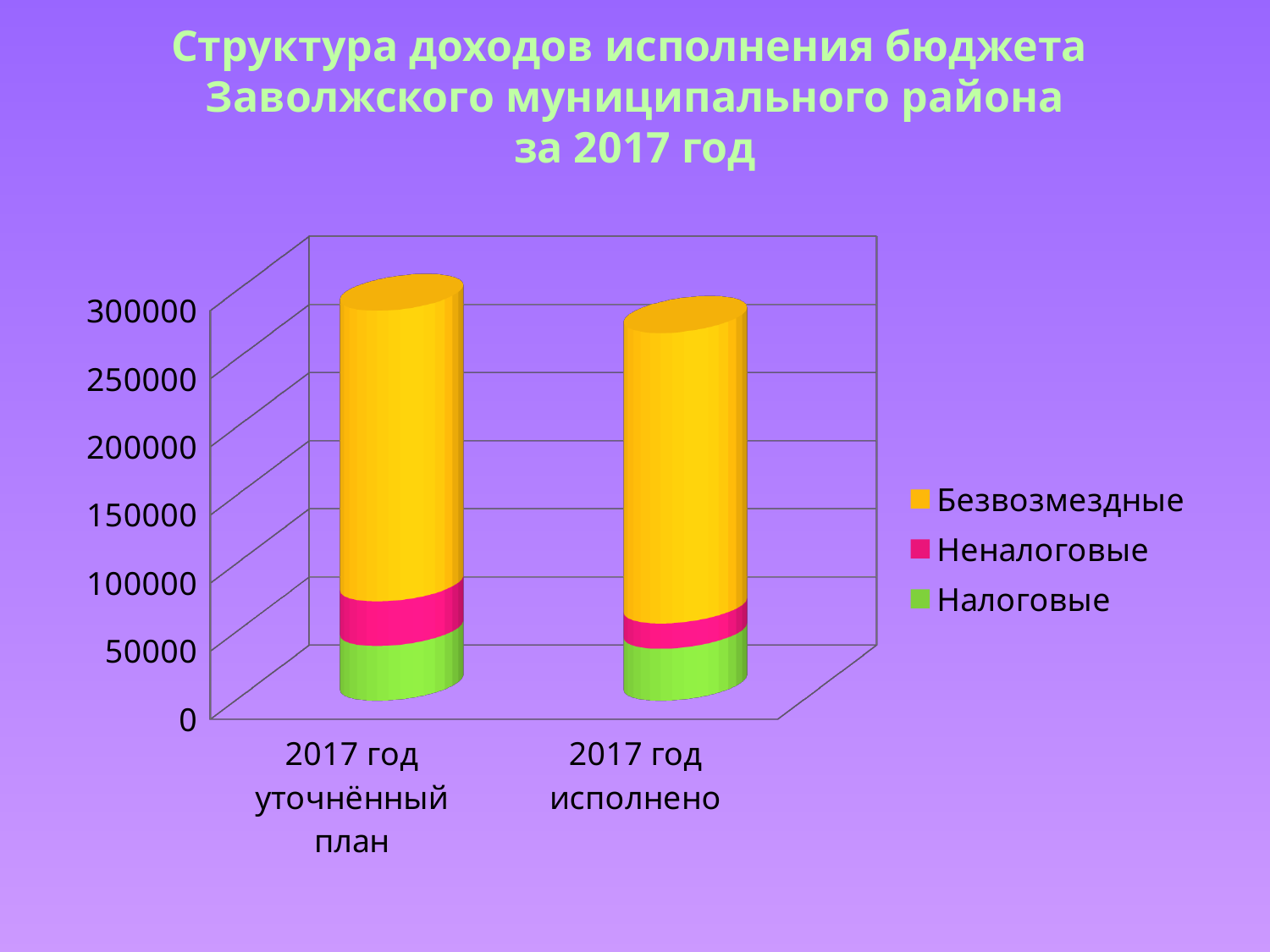
Which series is shown in yellow in the chart? Безвозмездные Is the value of 'Неналоговые' larger for '2017 год уточнённый план' or for '2017 год исполнено'? 2017 год уточнённый план How many series does the legend list? 3 Which series makes up the smallest part of the bar for '2017 год исполнено'? Неналоговые Is the total value of the bar for '2017 год исполнено' greater or less than 200000? greater Is the total value of the bar for '2017 год уточнённый план' greater or less than 200000? greater Does the total bar height rise or fall from '2017 год уточнённый план' to '2017 год исполнено'? fall Which series makes up the largest part of the bar for '2017 год исполнено'? Безвозмездные Which series is shown in green in the chart? Налоговые Which category has the higher total bar, '2017 год уточнённый план' or '2017 год исполнено'? 2017 год уточнённый план How many categories are shown on the x axis of the chart? 2 What kind of chart is shown on the slide? Stacked bar chart